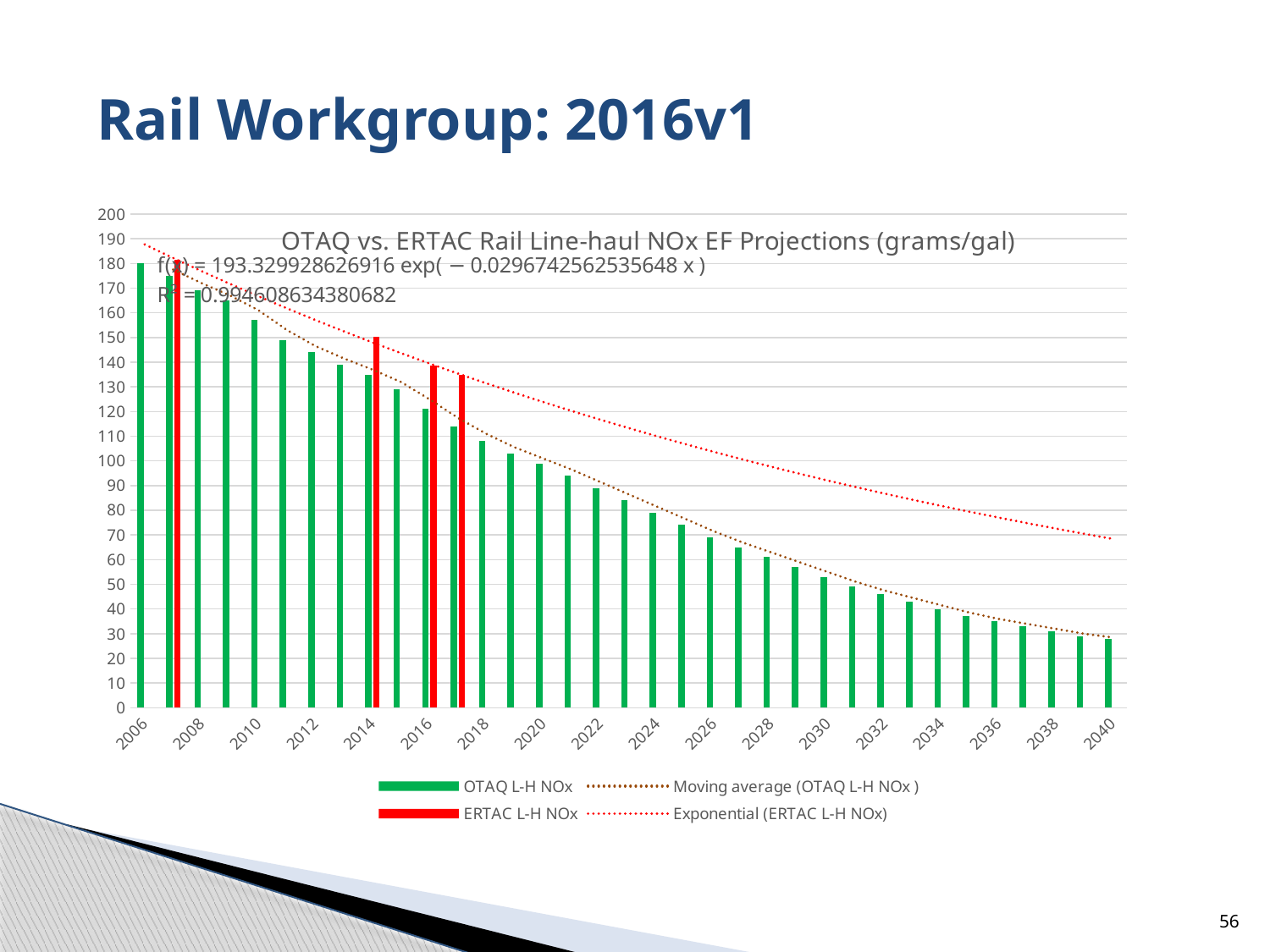
Which year has the lowest OTAQ L-H NOx value? 2040 Which year has the highest OTAQ L-H NOx value? 2006 What is the title of the chart? OTAQ vs. ERTAC Rail Line-haul NOx EF Projections (grams/gal) How many entries does the chart legend list? 4 What R² value is printed on the chart for the exponential trendline? 0.994608634380682 Do the OTAQ L-H NOx values rise or fall from 2006 to 2040? fall Is the OTAQ L-H NOx value for 2040 greater or less than 40? less Is the ERTAC L-H NOx value for 2014 greater or less than 140? greater How many red ERTAC L-H NOx bars are plotted on the chart? 4 In 2014, which is larger: the ERTAC L-H NOx value or the OTAQ L-H NOx value? ERTAC L-H NOx Is the OTAQ L-H NOx value for 2006 greater or less than 170? greater What kind of chart is shown on the slide? bar chart